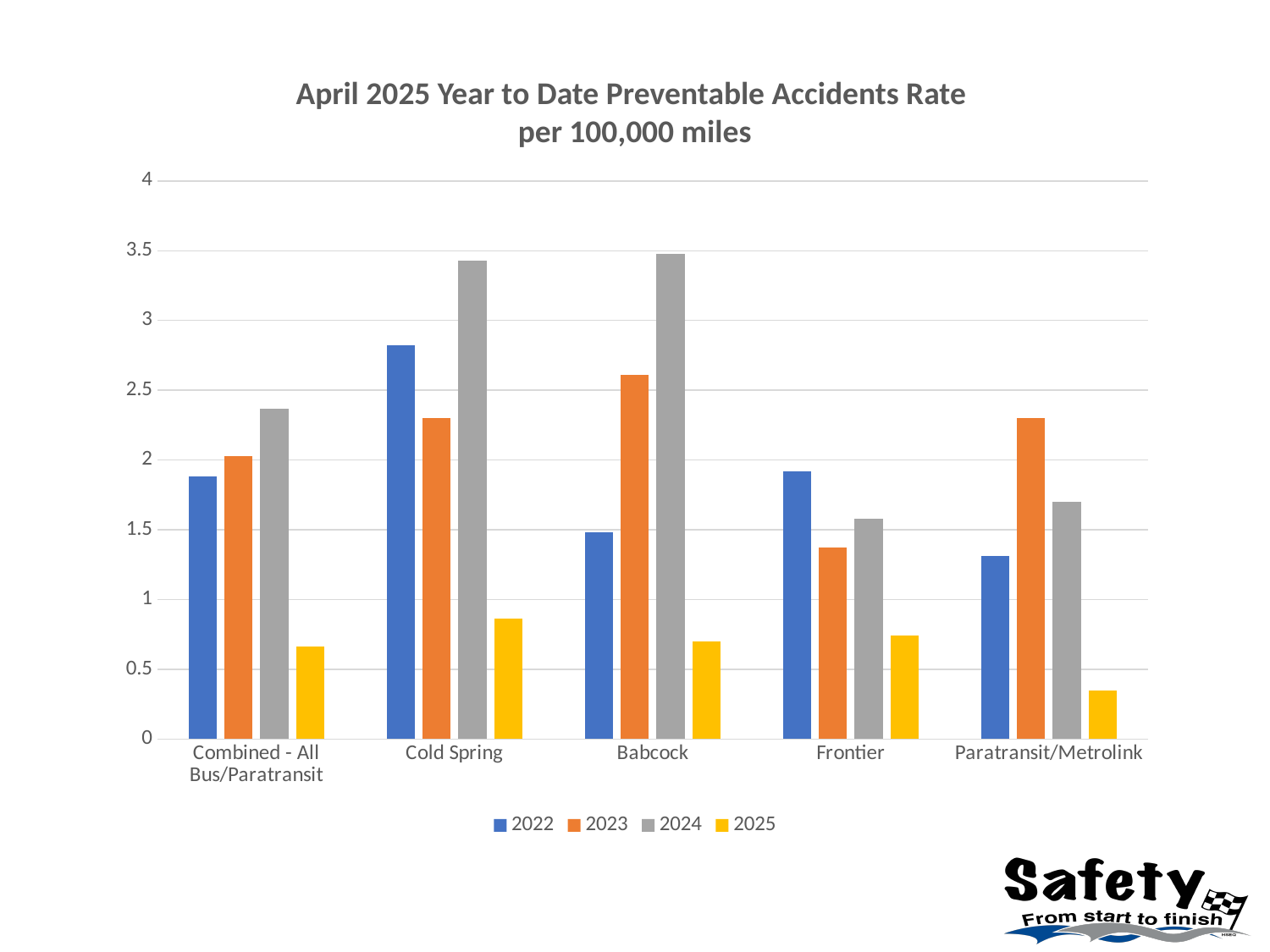
How many series does the legend list? 4 Which category has the lowest value for 2025? Paratransit/Metrolink What kind of chart is shown on the slide? bar chart Is the value for Cold Spring in 2024 greater or less than 3? greater What is the title of the chart? April 2025 Year to Date Preventable Accidents Rate per 100,000 miles How many categories are shown on the x axis? 5 Which category has the lowest value for 2023? Frontier Which category has the highest value for 2022? Cold Spring Which category has the highest value for 2023? Babcock For Frontier, which year has the larger value, 2022 or 2024? 2022 Is the value for Paratransit/Metrolink in 2025 greater or less than 0.5? less Is the value for Babcock in 2023 greater or less than 2.5? greater